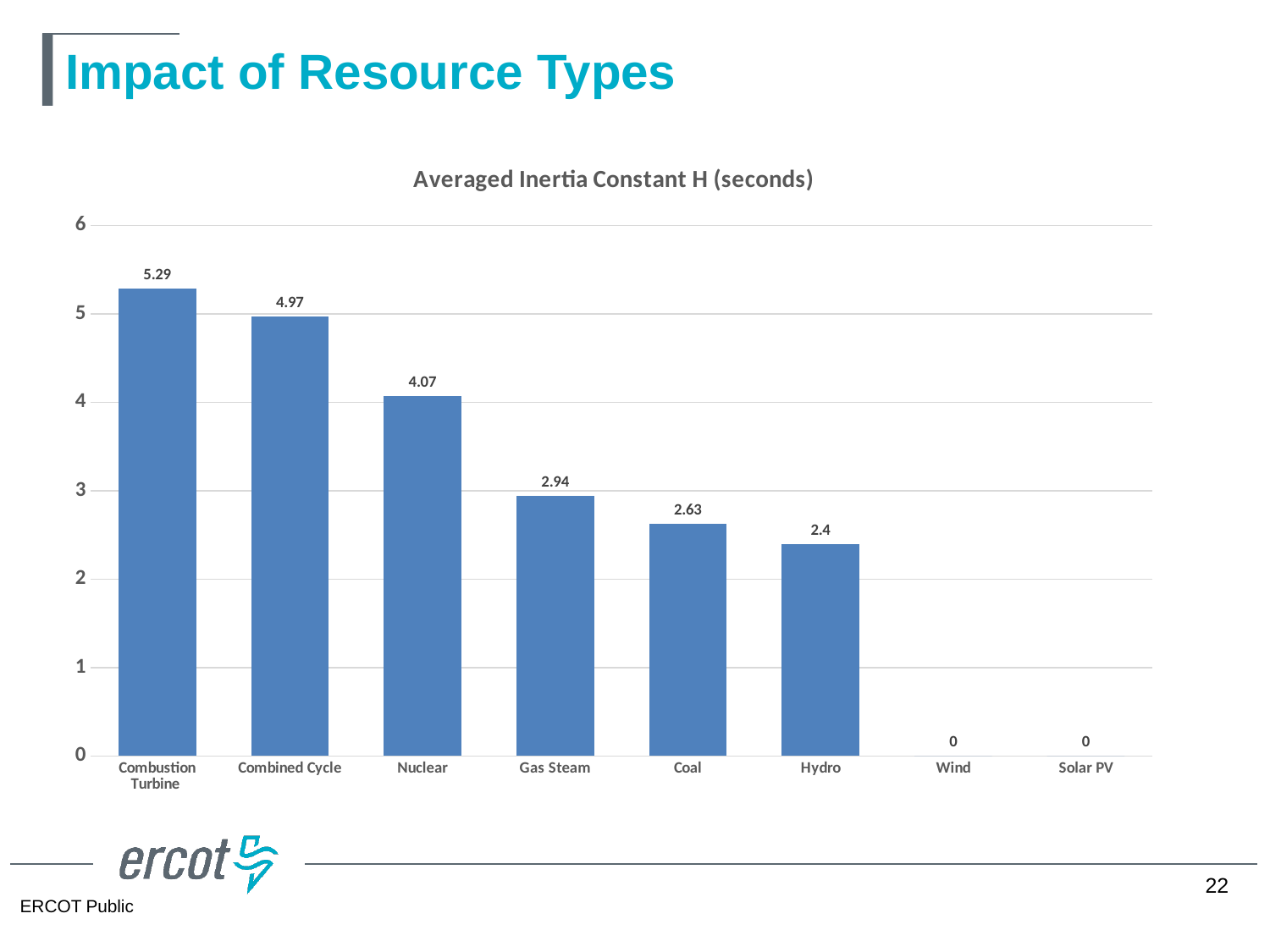
Is the value for Gas Steam greater or less than 3? less What is the averaged inertia constant H for Hydro? 2.4 What is the averaged inertia constant H for Wind? 0 What is the title of the chart? Averaged Inertia Constant H (seconds) What kind of chart is shown on the slide? Bar chart Which resource type has the highest averaged inertia constant H? Combustion Turbine What is the difference between the averaged inertia constant H for Combined Cycle and Gas Steam? 2.03 How many resource types are shown on the x axis? 8 Which resource type has the lowest non-zero averaged inertia constant H? Hydro What is the averaged inertia constant H for Nuclear? 4.07 What is the averaged inertia constant H for Combustion Turbine? 5.29 Which has a larger averaged inertia constant H, Coal or Nuclear? Nuclear